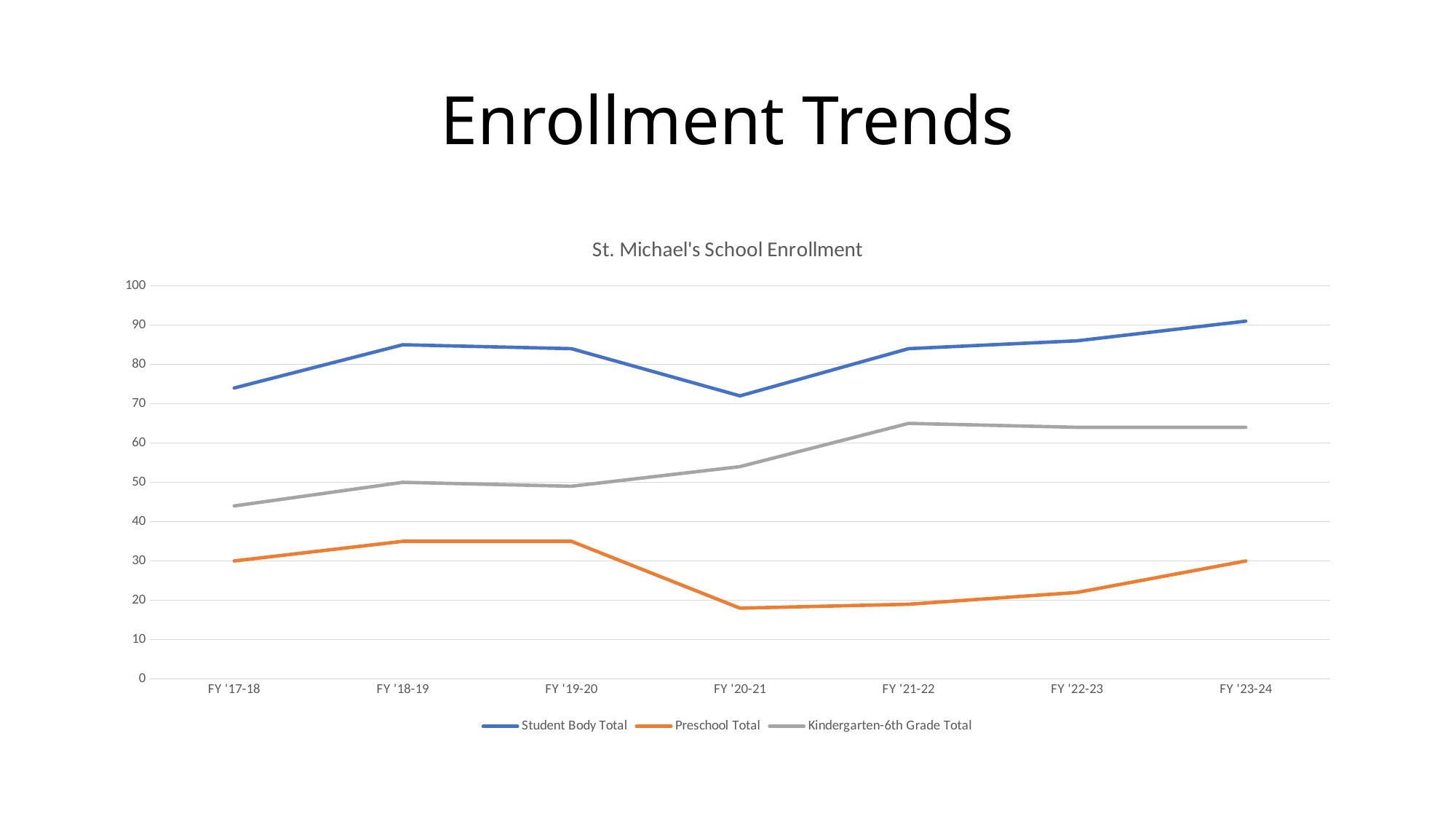
In which fiscal year is the Kindergarten-6th Grade Total lowest? FY '17-18 Is the Kindergarten-6th Grade Total for FY '21-22 greater or less than 60? greater In which fiscal year is the Student Body Total highest? FY '23-24 Which is larger in FY '19-20, the Preschool Total or the Kindergarten-6th Grade Total? Kindergarten-6th Grade Total Is the Student Body Total for FY '20-21 greater or less than 70? greater Is the Preschool Total for FY '20-21 greater or less than 20? less What kind of chart is shown on the slide? line chart Which series is drawn in orange? Preschool Total In which fiscal year is the Student Body Total lowest? FY '20-21 How many series does the legend list? 3 What is the title of the chart? St. Michael's School Enrollment How many fiscal years are plotted along the x axis? 7